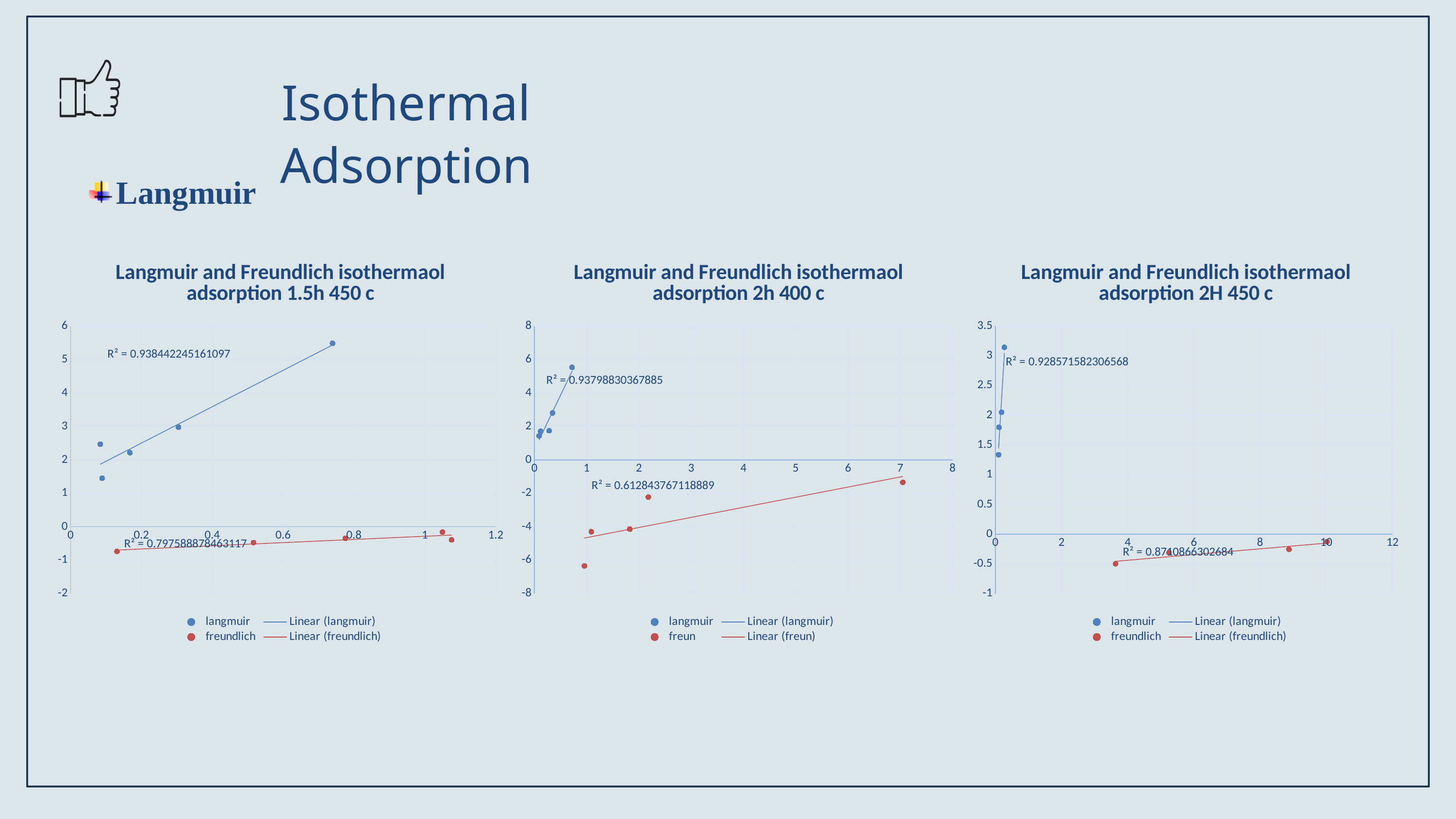
In the 'Langmuir and Freundlich isothermaol adsorption 1.5h 450 c' chart, what is the R² value shown for the freundlich trend line? R² = 0.797588878463117 In the 'Langmuir and Freundlich isothermaol adsorption 2h 400 c' chart, is the lowest freun point greater or less than -6? less How many entries does the legend of the 'Langmuir and Freundlich isothermaol adsorption 2h 400 c' chart list? 4 What kind of chart is the 'Langmuir and Freundlich isothermaol adsorption 1.5h 450 c' chart? Scatter chart In the 'Langmuir and Freundlich isothermaol adsorption 2h 400 c' chart, does the freun trend line rise or fall as x increases? Rises In the 'Langmuir and Freundlich isothermaol adsorption 2h 400 c' chart, what is the R² value shown for the langmuir trend line? R² = 0.93798830367885 In the 'Langmuir and Freundlich isothermaol adsorption 2h 400 c' chart, what is the R² value shown for the freun trend line? R² = 0.612843767118889 In the 'Langmuir and Freundlich isothermaol adsorption 1.5h 450 c' chart, is the highest langmuir point greater or less than 5? greater In the 'Langmuir and Freundlich isothermaol adsorption 1.5h 450 c' chart, what is the R² value shown for the langmuir trend line? R² = 0.938442245161097 In the 'Langmuir and Freundlich isothermaol adsorption 2H 450 c' chart, how many freundlich data points are plotted? 4 In the 'Langmuir and Freundlich isothermaol adsorption 2H 450 c' chart, what is the R² value shown for the langmuir trend line? R² = 0.928571582306568 In the 'Langmuir and Freundlich isothermaol adsorption 1.5h 450 c' chart, which trend line has the larger R² value, langmuir or freundlich? langmuir